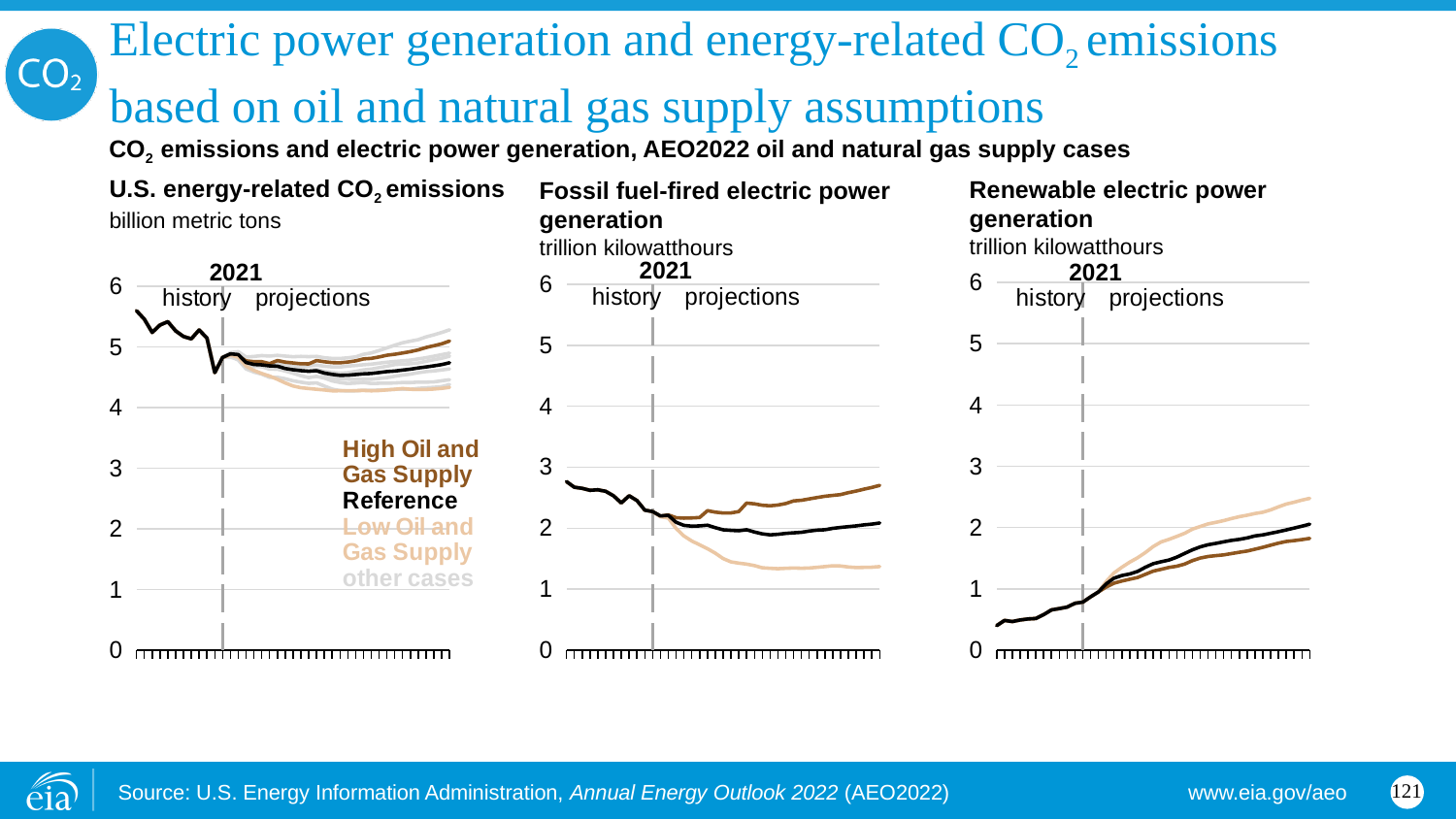
In the Renewable electric power generation chart, is the High Oil and Gas Supply value at the end of the projections greater or less than 2? less In the Renewable electric power generation chart, which case is higher at the end of the projections, High Oil and Gas Supply or Low Oil and Gas Supply? Low Oil and Gas Supply How many entries does the legend on the U.S. energy-related CO2 emissions chart list? 4 In the Fossil fuel-fired electric power generation chart, which case is higher at the end of the projections, High Oil and Gas Supply or Low Oil and Gas Supply? High Oil and Gas Supply What kind of chart is the U.S. energy-related CO2 emissions chart? line chart What unit is used on the U.S. energy-related CO2 emissions chart? billion metric tons What year does the dashed vertical line separating history from projections mark on the charts? 2021 In the Renewable electric power generation chart, do the values rise or fall over the projection period? rise In the Fossil fuel-fired electric power generation chart, is the High Oil and Gas Supply value at the end of the projections greater or less than 2? greater In the Fossil fuel-fired electric power generation chart, does the Low Oil and Gas Supply line rise or fall over the projection period? fall In the U.S. energy-related CO2 emissions chart, is the Reference case value at the end of the projections greater or less than 5? less